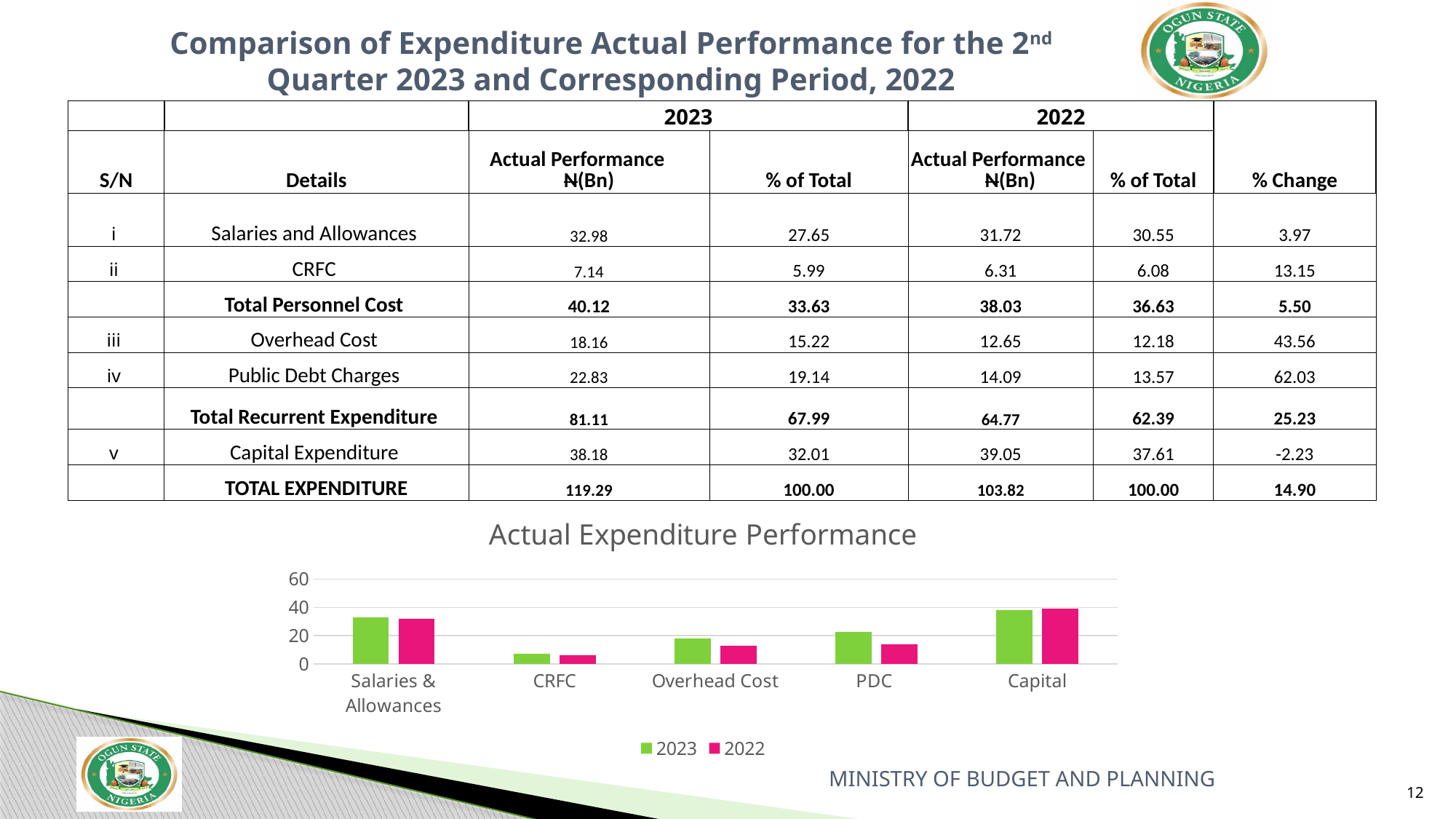
In the 'Actual Expenditure Performance' chart, is the 2022 value for Capital greater or less than 20? greater In the 'Actual Expenditure Performance' chart, which is larger for Overhead Cost: the 2023 bar or the 2022 bar? 2023 In the 'Actual Expenditure Performance' chart, is the 2023 value for Salaries & Allowances greater or less than 20? greater In the 'Actual Expenditure Performance' chart, is the 2023 value for CRFC greater or less than 20? less In the 'Actual Expenditure Performance' chart, which is larger for PDC: the 2023 bar or the 2022 bar? 2023 What kind of chart is shown under the title 'Actual Expenditure Performance'? bar chart What colour are the 2022 bars in the 'Actual Expenditure Performance' chart? pink How many categories are shown on the x axis of the 'Actual Expenditure Performance' chart? 5 In the 'Actual Expenditure Performance' chart, which category has the lowest 2022 bar? CRFC In the 'Actual Expenditure Performance' chart, which category has the highest 2023 bar? Capital How many series does the legend of the 'Actual Expenditure Performance' chart list? 2 What is the title of the bar chart on the slide? Actual Expenditure Performance